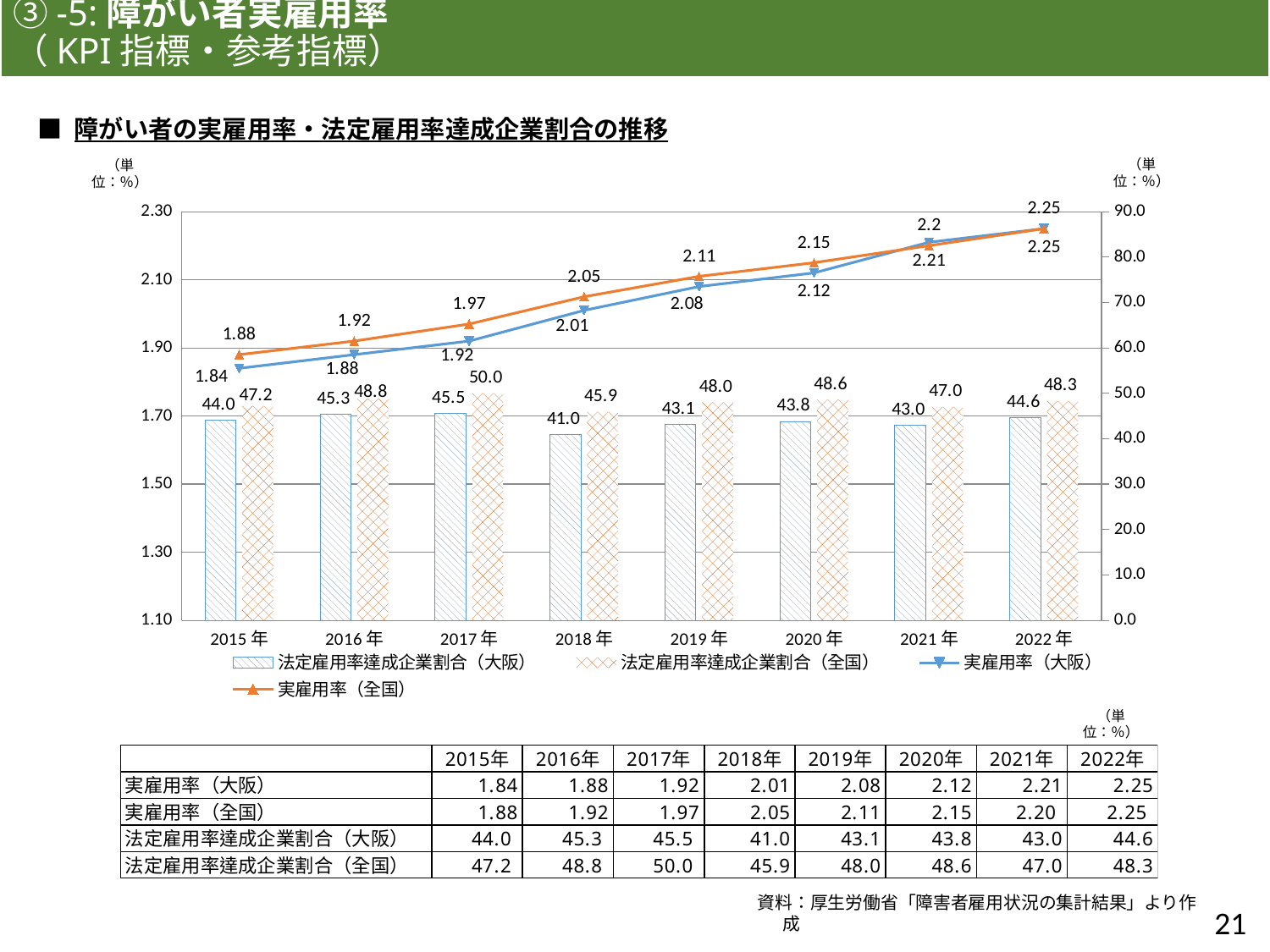
In which year is 法定雇用率達成企業割合（大阪） highest? 2017年 By how much did 実雇用率（大阪） increase from 2015年 to 2022年? 0.41 In which year is 法定雇用率達成企業割合（全国） lowest? 2018年 In 2019年, which is larger: 実雇用率（大阪） or 実雇用率（全国）? 実雇用率（全国） What is the difference between 法定雇用率達成企業割合（全国） and 法定雇用率達成企業割合（大阪） in 2022年? 3.7 What is the value of 実雇用率（大阪） for 2018年? 2.01 What kind of chart is shown on the slide? Combined bar and line chart How many series does the chart legend list? 4 How many years are shown on the x axis of the chart? 8 Does 実雇用率（大阪） rise or fall from 2015年 to 2022年? Rise What is the value of 法定雇用率達成企業割合（全国） for 2017年? 50.0 What is the value of 実雇用率（全国） for 2015年? 1.88